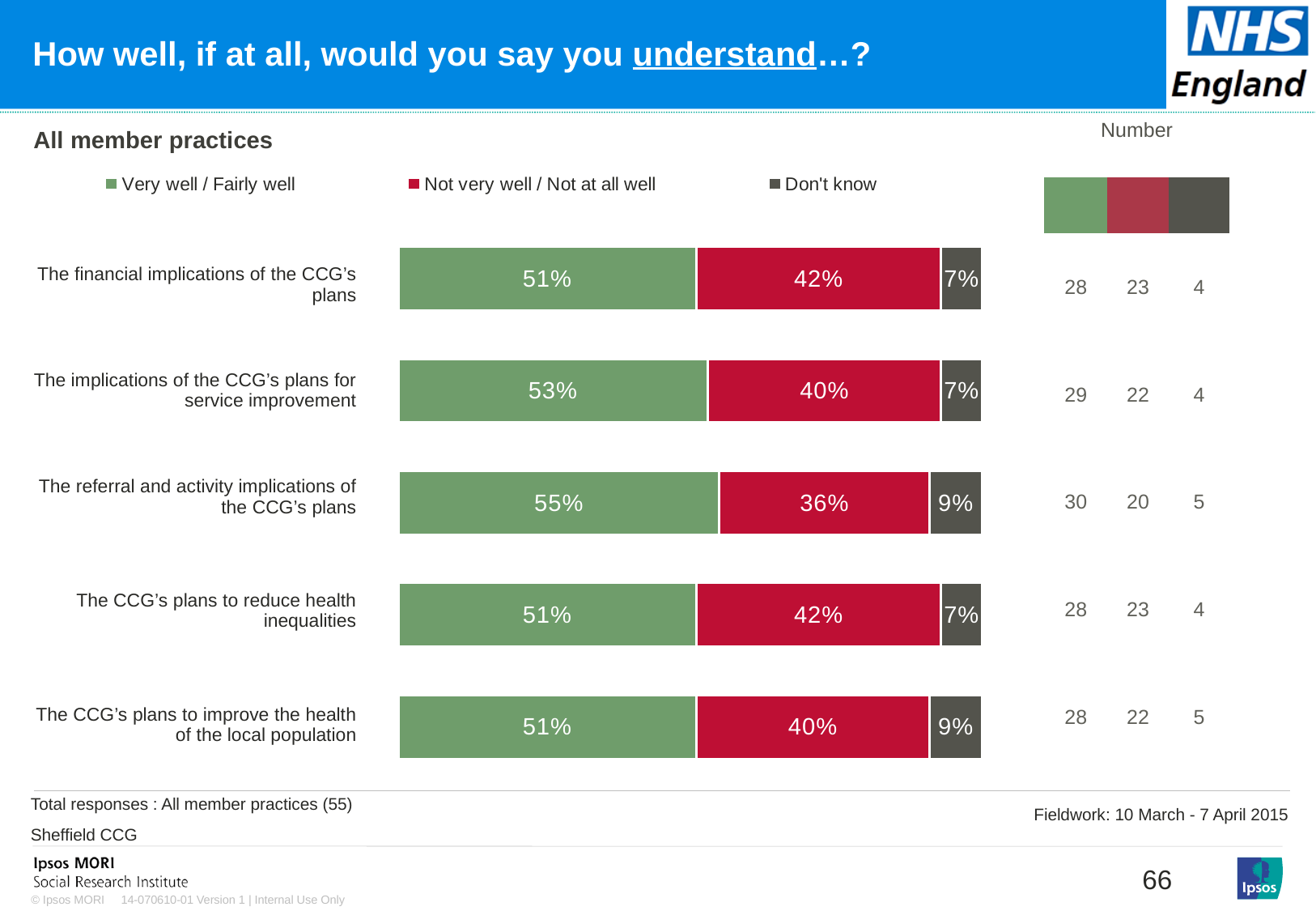
How many series does the legend list? 3 What kind of chart is shown on the slide? Stacked bar chart Which colour represents 'Don't know' in the legend? Dark grey Is the 'Very well / Fairly well' percentage higher for the implications of the CCG's plans for service improvement or for the CCG's plans to reduce health inequalities? The implications of the CCG's plans for service improvement How many items (categories) are shown in the chart? 5 Which item has the lowest 'Not very well / Not at all well' percentage? The referral and activity implications of the CCG's plans What percentage said they understand the referral and activity implications of the CCG's plans not very well or not at all well? 36% What is the 'Don't know' percentage for the CCG's plans to improve the health of the local population? 9% Which item has the highest 'Very well / Fairly well' percentage? The referral and activity implications of the CCG's plans What is the total of the three segments for the CCG's plans to reduce health inequalities? 100% What is the difference between the 'Very well / Fairly well' and 'Not very well / Not at all well' percentages for the implications of the CCG's plans for service improvement? 13 percentage points What percentage of respondents said they understand the financial implications of the CCG's plans very well or fairly well? 51%